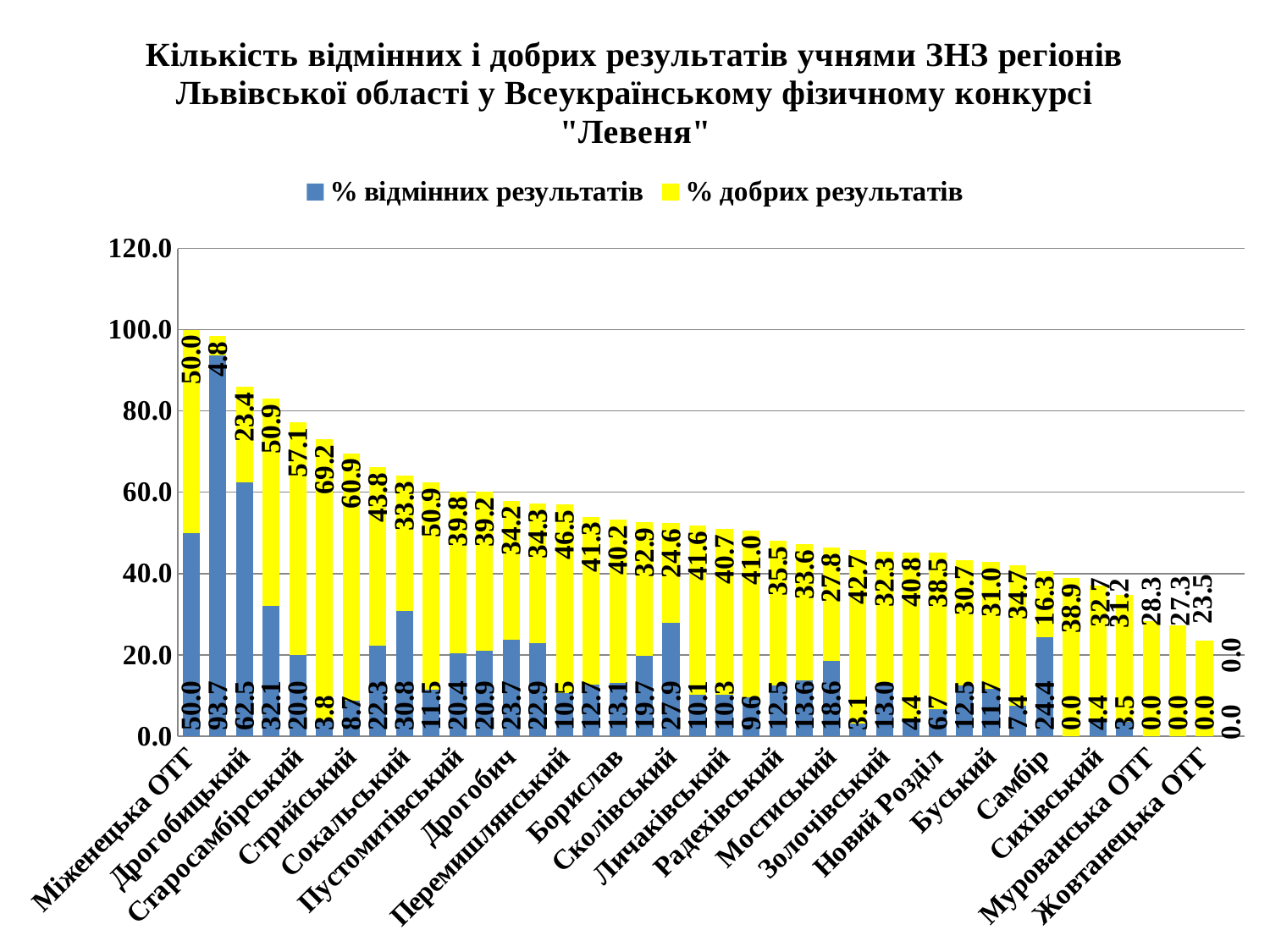
What is the % відмінних результатів value for Міженецька ОТГ? 50.0 What is the highest value shown for % добрих результатів? 69.2 What is the % добрих результатів value for Міженецька ОТГ? 50.0 Is the total of the stacked bar for Жовтанецька ОТГ greater or less than 40.0? less Do the total bar heights generally rise or fall from left to right along the x axis? Fall What is the highest value shown for % відмінних результатів? 93.7 How many series does the legend list? 2 What is the total of the stacked bar for Міженецька ОТГ? 100.0 What kind of chart is shown on the slide? Stacked bar chart Which colour represents % добрих результатів? Yellow What are the two series named in the legend? % відмінних результатів and % добрих результатів What is the % відмінних результатів value for Дрогобицький? 62.5